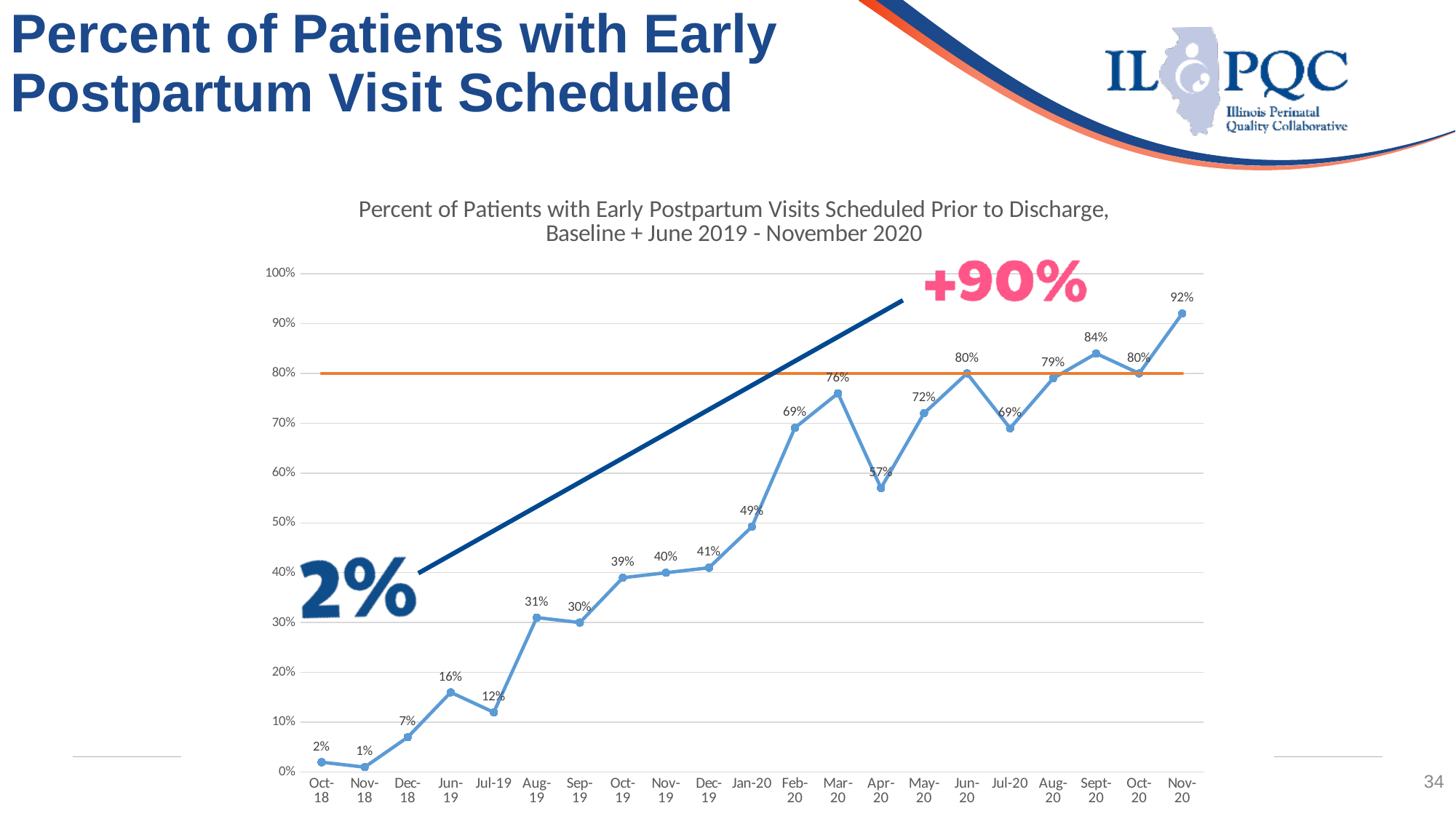
Which month has the highest value? Nov-20 What is the value for Nov-20? 92% Which is larger, the value for Mar-20 or the value for May-20? Mar-20 Do the values generally rise or fall from Oct-18 to Nov-20? Rise What is the value for Sept-20? 84% What kind of chart is shown? Line chart How many data points are plotted on the chart? 21 Which month has the lowest value? Nov-18 At what value is the orange horizontal line drawn? 80% What is the difference between the value for Nov-20 and the value for Oct-18? 90 percentage points What is the value for Apr-20? 57% What is the value for Jan-20? 49%